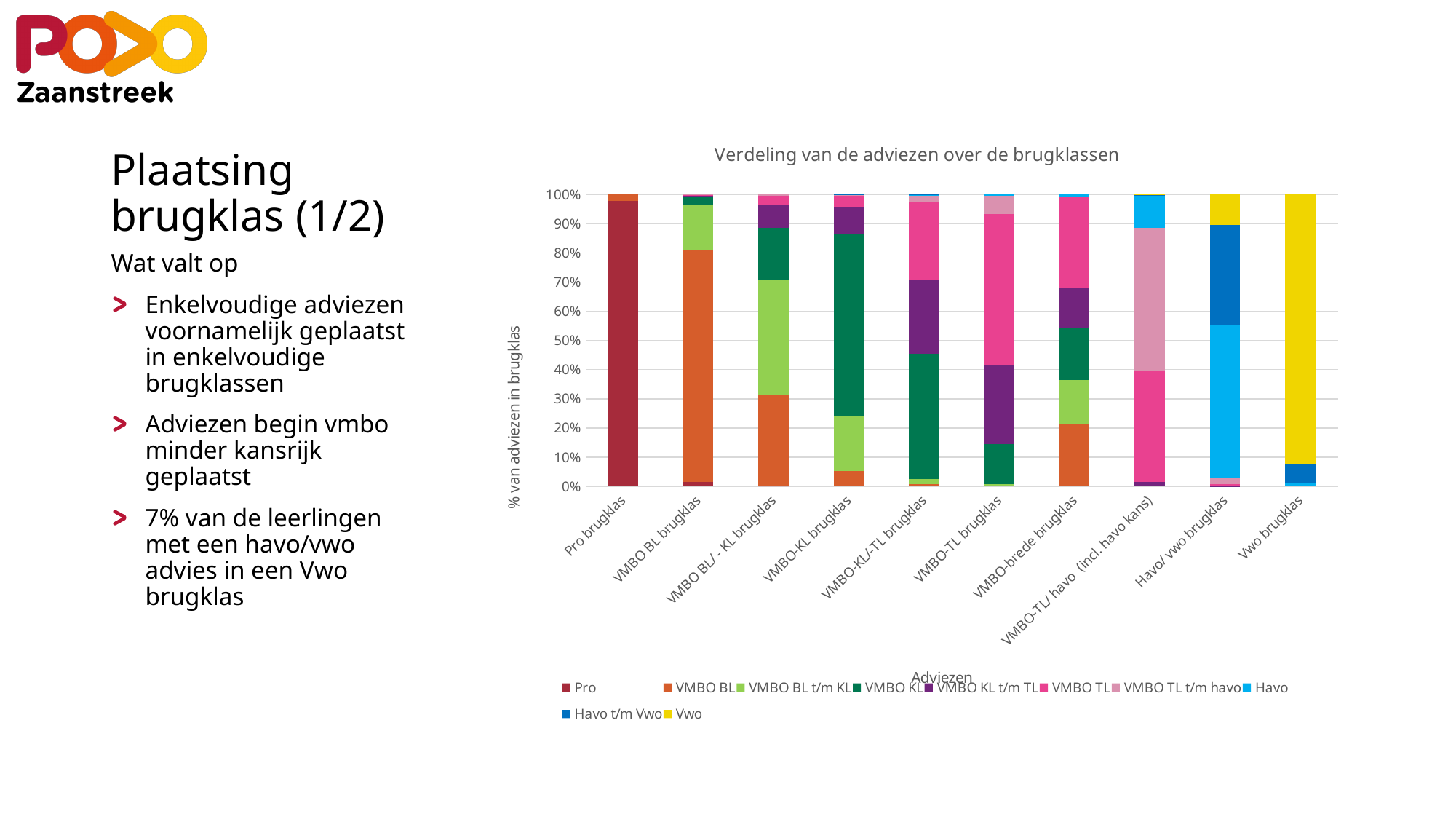
Is the VMBO KL share in the VMBO-KL brugklas bar greater or less than 50%? greater How many brugklas categories are shown on the x axis of the chart? 10 Is the VMBO BL share in the VMBO BL brugklas bar greater or less than 70%? greater How many series does the chart legend list? 10 Which is larger: the Pro share in the Pro brugklas bar or the VMBO BL share in the VMBO BL brugklas bar? Pro share in the Pro brugklas What is the label of the vertical axis? % van adviezen in brugklas What type of chart is shown on the slide? Stacked bar chart Is the Vwo share in the Vwo brugklas bar greater or less than 90%? greater What is the title of the chart? Verdeling van de adviezen over de brugklassen Which brugklas has the largest Vwo share? Vwo brugklas